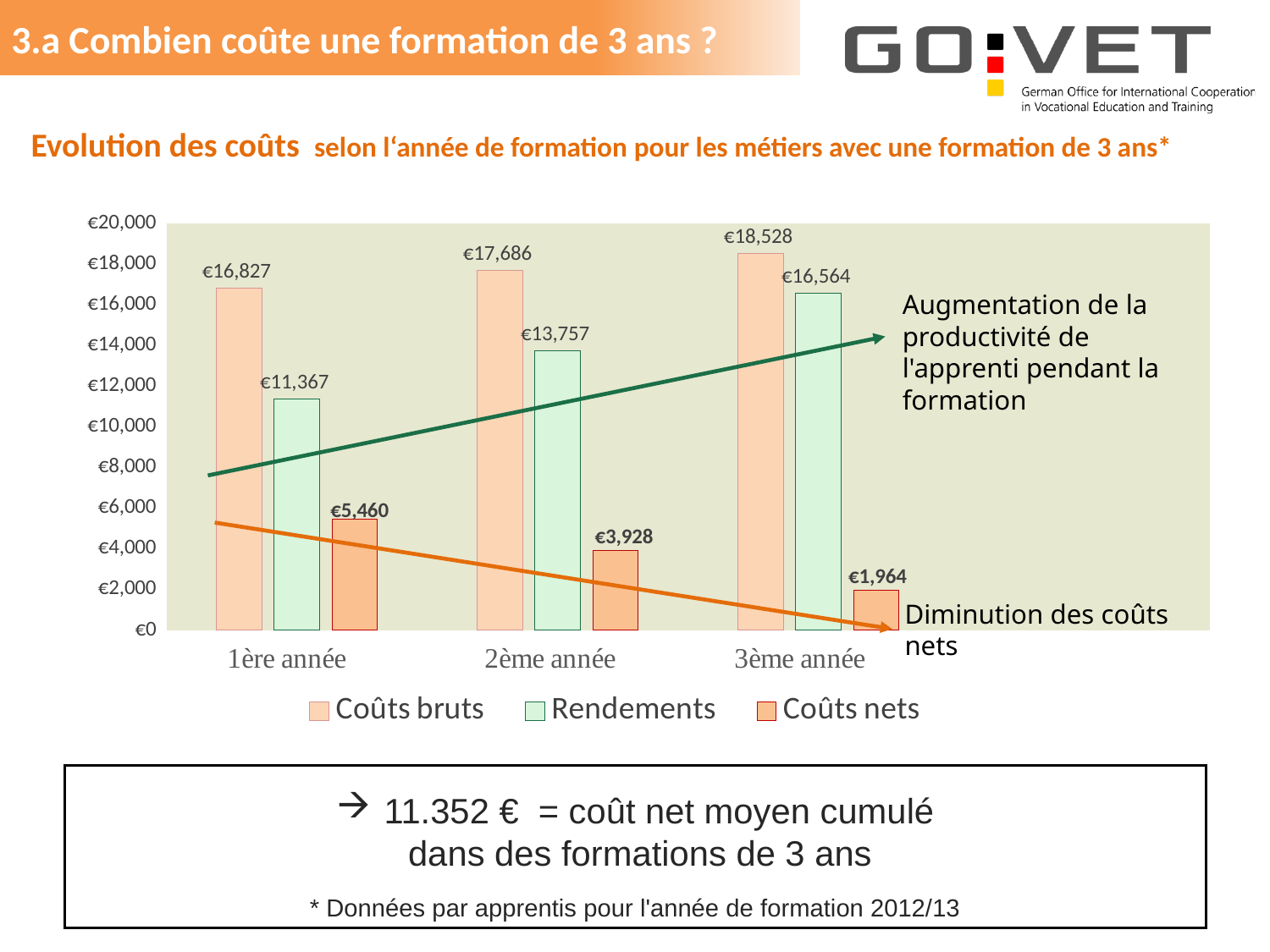
What is the value of Rendements for 2ème année? €13,757 How many series does the legend list? 3 What is the value of Coûts nets for 3ème année? €1,964 What is the difference between Coûts bruts and Rendements in 1ère année? €5,460 What are the three series listed in the legend? Coûts bruts, Rendements, Coûts nets In which year are Coûts bruts highest? 3ème année What is the value of Coûts bruts for 1ère année? €16,827 What kind of chart is shown on the slide? Bar chart Do the Rendements values rise or fall from 1ère année to 3ème année? Rise In which year are Coûts nets lowest? 3ème année How many years (categories) are shown on the x axis? 3 Which is larger in 2ème année: Coûts bruts or Rendements? Coûts bruts